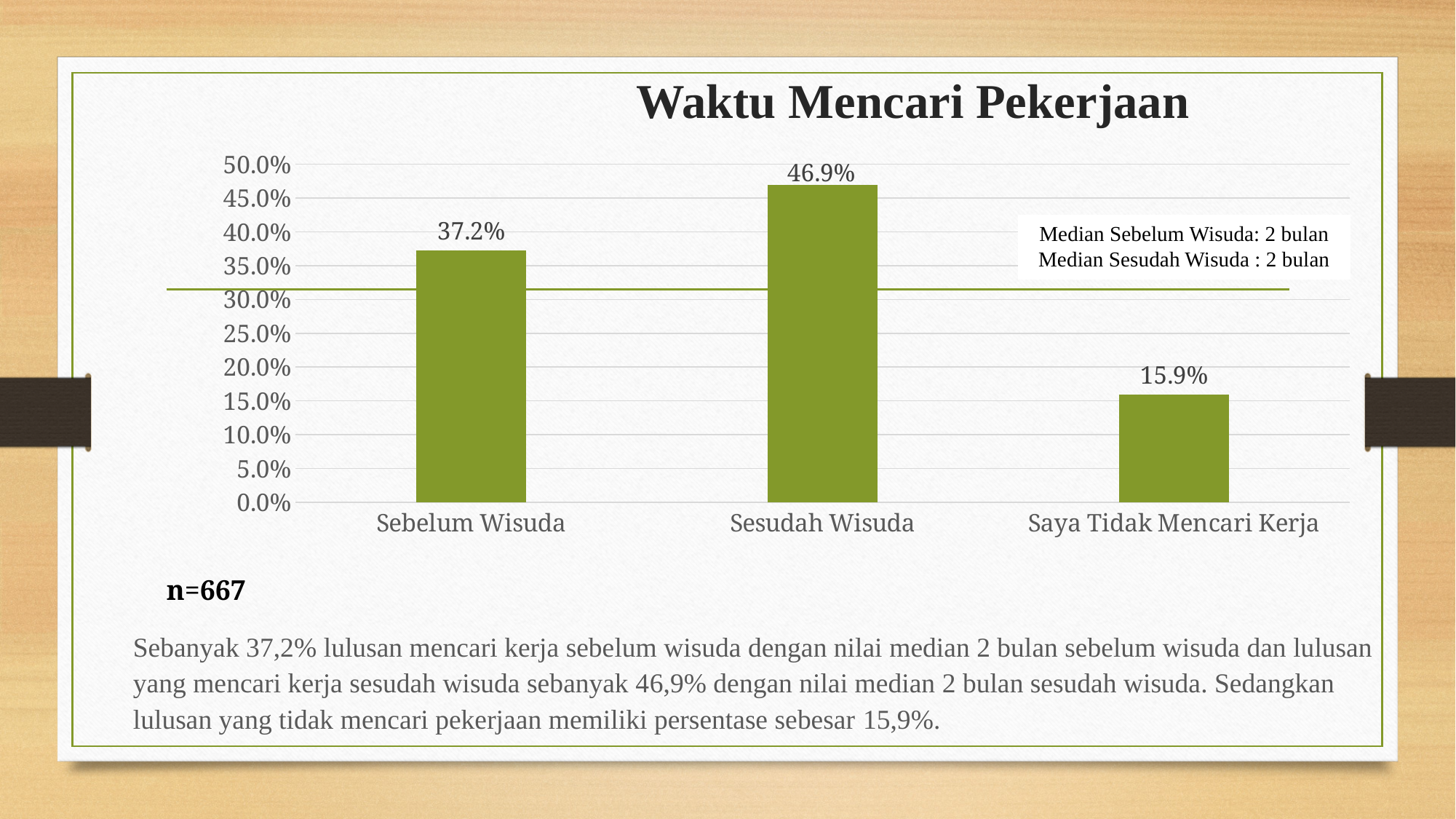
What is the difference between the values for Sesudah Wisuda and Sebelum Wisuda? 9.7% What is the value for Sesudah Wisuda? 46.9% Is the value for Sesudah Wisuda greater or less than 45.0%? greater Which category has the highest value? Sesudah Wisuda What is the title of the chart? Waktu Mencari Pekerjaan Which is larger, the value for Sebelum Wisuda or the value for Saya Tidak Mencari Kerja? Sebelum Wisuda Which category has the lowest value? Saya Tidak Mencari Kerja What is the difference between the values for Sebelum Wisuda and Saya Tidak Mencari Kerja? 21.3% What is the value for Saya Tidak Mencari Kerja? 15.9% What is the value for Sebelum Wisuda? 37.2% How many categories are shown on the x axis? 3 What kind of chart is shown on the slide? bar chart